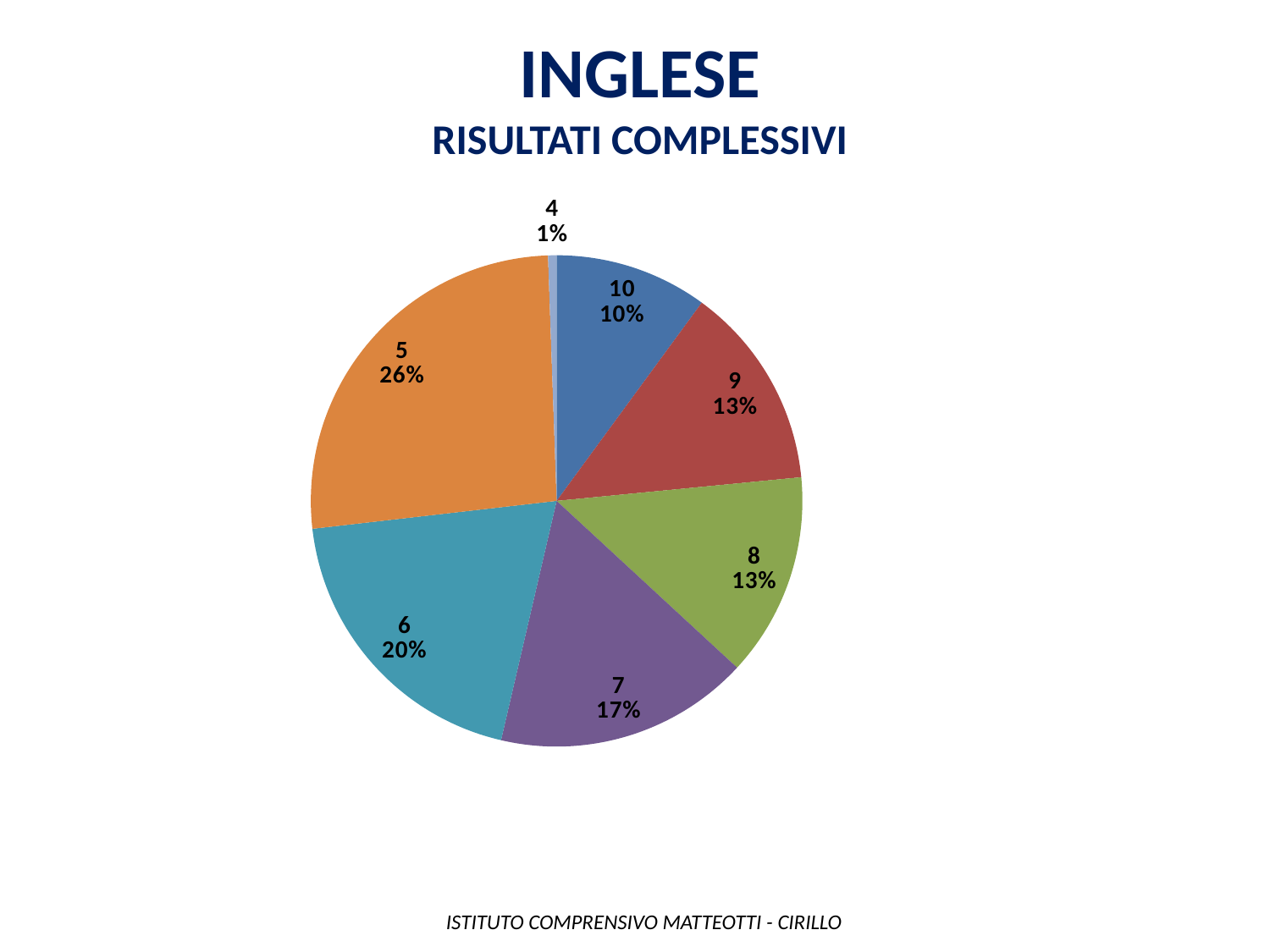
How many slices does the pie chart have? 7 What percentage is shown for grade 10? 10% What is the combined share of grades 8 and 9? 26% What percentage is shown for grade 4? 1% What is the difference in percentage points between grade 6 and grade 10? 10 What is the title of the slide above the chart? INGLESE RISULTATI COMPLESSIVI What percentage is shown for grade 7? 17% Which grade has the smallest slice of the pie? 4 What share of the pie does grade 5 represent? 26% What kind of chart is shown on the slide? pie chart Which grade has the largest slice of the pie? 5 Which is larger, the share for grade 6 or the share for grade 7? grade 6